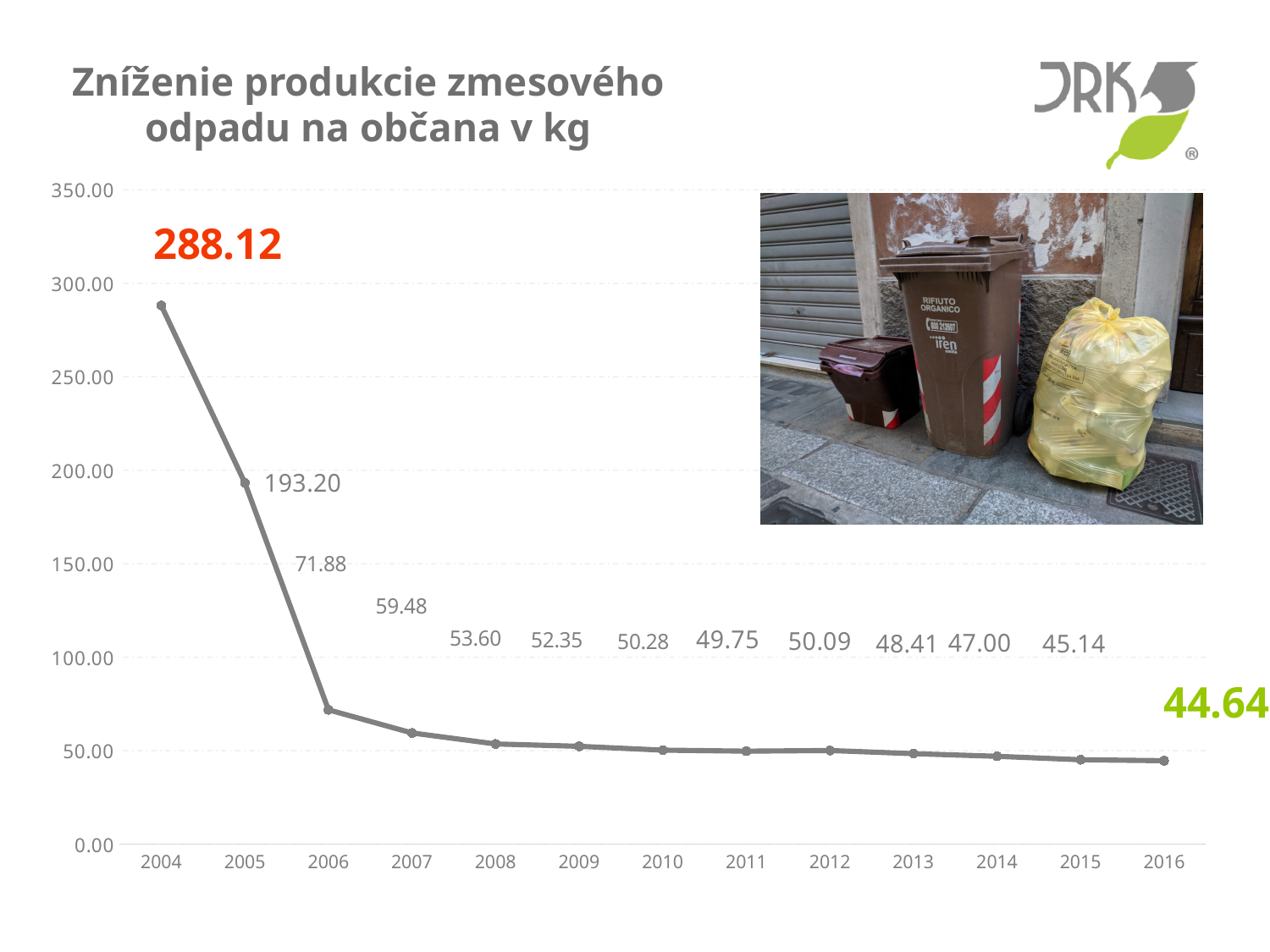
Which year has the lowest value? 2016 What is the value for 2004? 288.12 What is the difference between the values for 2004 and 2005? 94.92 What is the value for 2016? 44.64 What is the value for 2012? 50.09 What is the difference between the values for 2015 and 2016? 0.50 What is the value for 2006? 71.88 How many years are plotted on the x axis? 13 Do the values generally rise or fall from 2004 to 2016? fall What kind of chart is shown? line chart Which year has the highest value? 2004 Which is larger, the value for 2007 or the value for 2008? 2007